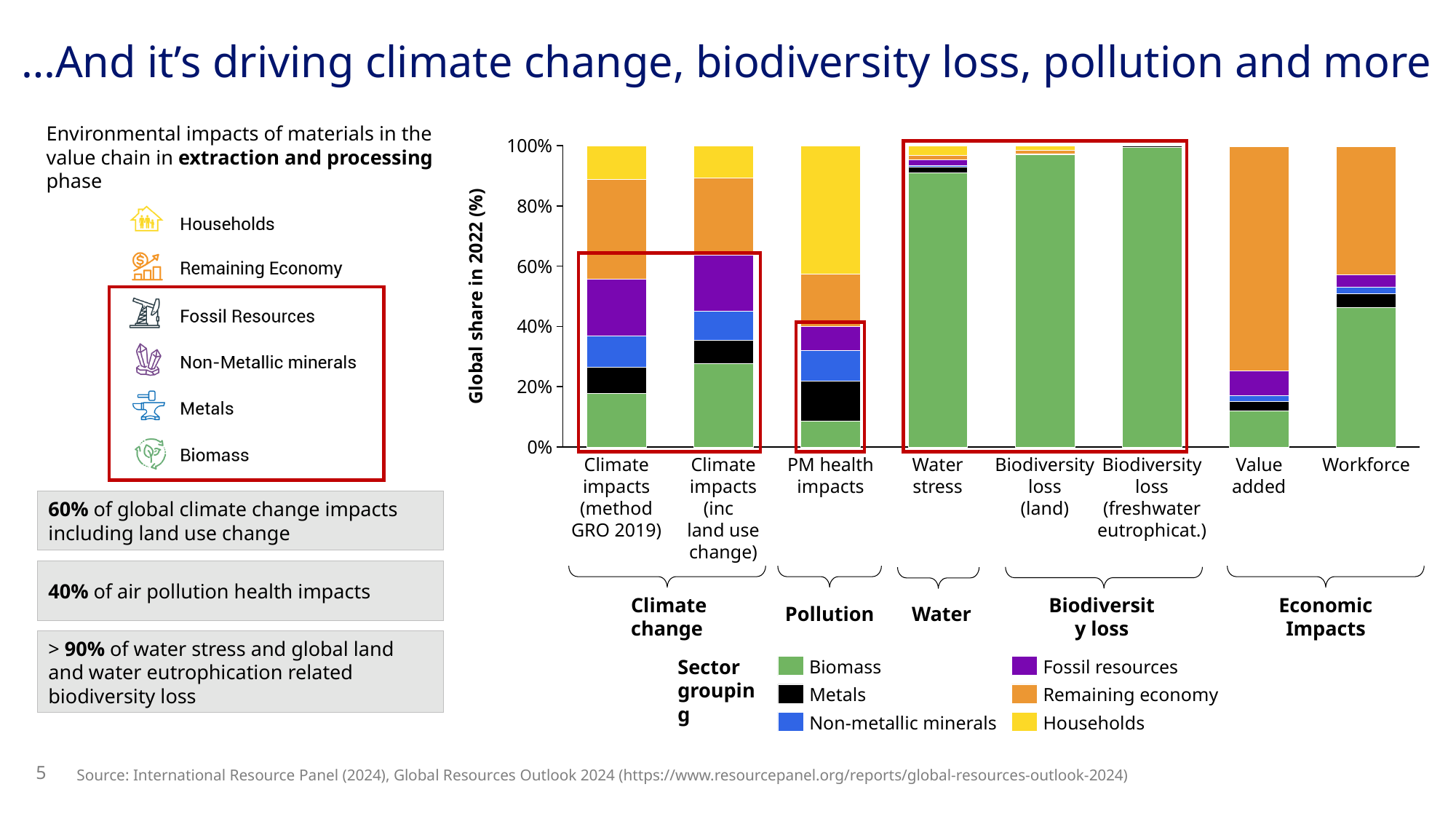
Which has the larger Biomass share: Water stress or PM health impacts? Water stress What kind of chart is shown on the slide? bar chart Is the Biomass share for PM health impacts greater or less than 20%? less Which category has the largest Households share? PM health impacts How many series does the chart's legend list? 6 Which category has the largest Remaining economy share? Value added What is the total of the stacked bar for Water stress? 100% What is the title of the chart's y axis? Global share in 2022 (%) Is the Biomass share for Water stress greater or less than 80%? greater How many categories are plotted along the x axis of the chart? 8 Is the Biomass share for Workforce greater or less than 40%? greater